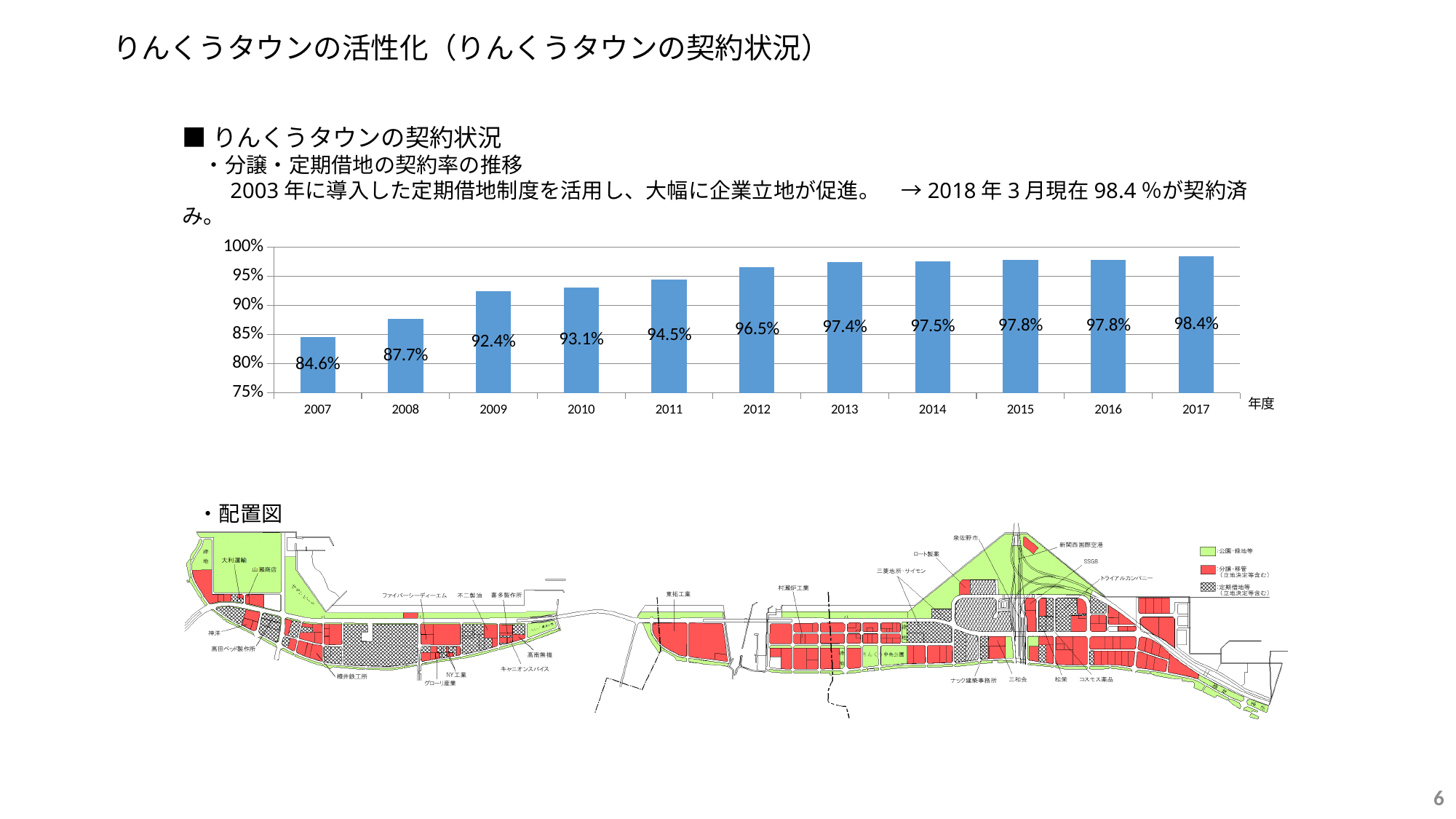
What is the contract rate for 2012? 96.5% Do the contract rate values rise or fall from 2007 to 2017? Rise Which year has the highest contract rate? 2017 How many years are shown on the x axis of the chart? 11 What is the contract rate for 2017? 98.4% Is the value for 2007 greater or less than 85%? less What kind of chart is used to show the contract rate by year? Bar chart What is the contract rate for 2007? 84.6% What is the difference in contract rate between 2017 and 2007? 13.8 percentage points Which year has a higher contract rate, 2009 or 2012? 2012 What is the difference in contract rate between 2008 and 2007? 3.1 percentage points Which year has the lowest contract rate? 2007